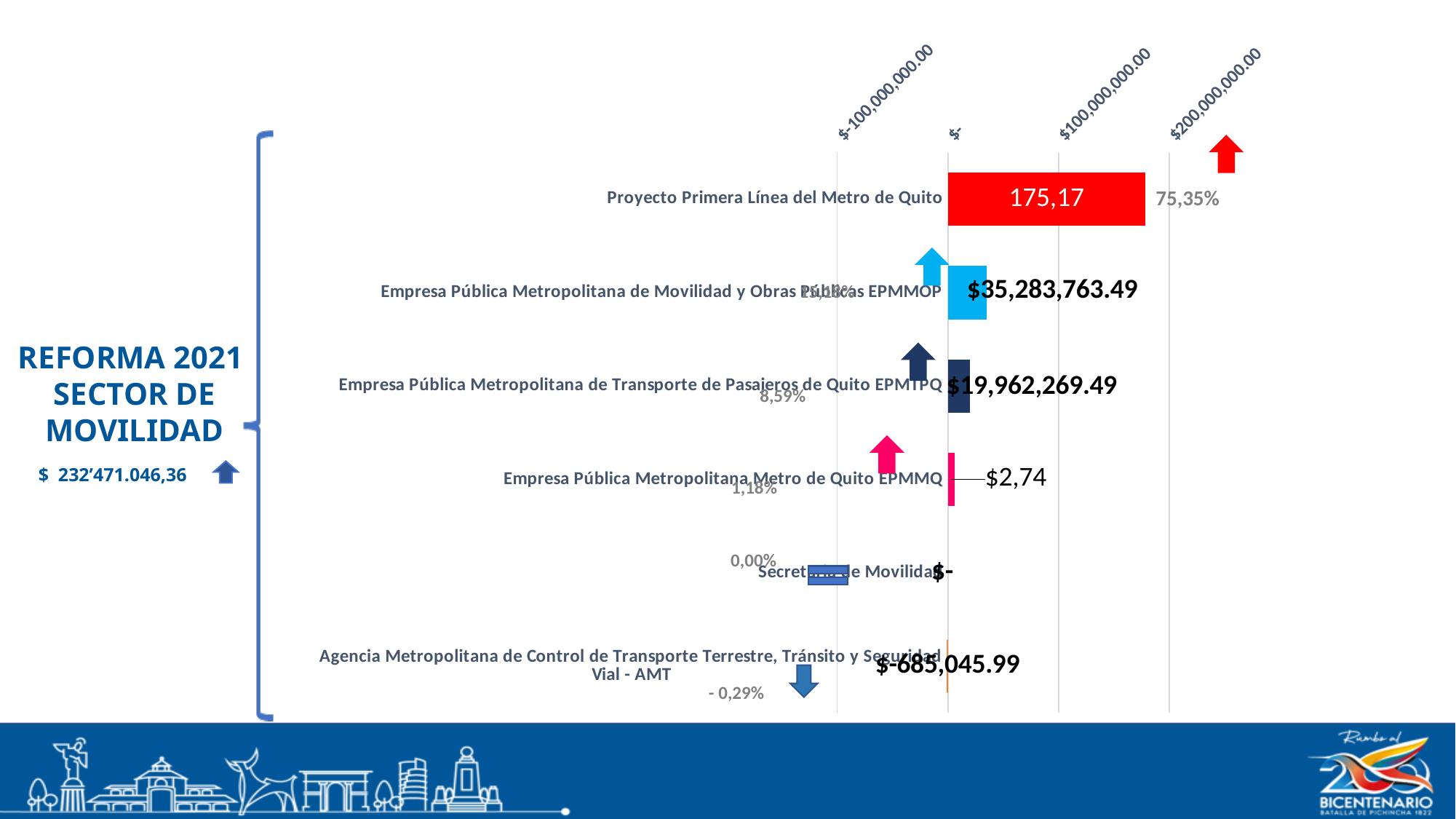
What kind of chart is shown on the slide? bar chart What is the data label shown for Empresa Pública Metropolitana de Movilidad y Obras Públicas EPMMOP? $35,283,763.49 What percentage is shown next to Proyecto Primera Línea del Metro de Quito? 75,35% How many categories are plotted in the chart? 6 What percentage is shown for Empresa Pública Metropolitana de Transporte de Pasajeros de Quito EPMTPQ? 8,59% Which category has the longest bar in the chart? Proyecto Primera Línea del Metro de Quito Is the value for Proyecto Primera Línea del Metro de Quito greater or less than $100,000,000.00? greater What data label is printed on the bar for Proyecto Primera Línea del Metro de Quito? 175,17 What is the data label shown for Empresa Pública Metropolitana de Transporte de Pasajeros de Quito EPMTPQ? $19,962,269.49 What is the data label shown for Agencia Metropolitana de Control de Transporte Terrestre, Tránsito y Seguridad Vial - AMT? $-685,045.99 Which is larger, the value for EPMMOP or the value for EPMTPQ? EPMMOP Which category has the lowest value in the chart? Agencia Metropolitana de Control de Transporte Terrestre, Tránsito y Seguridad Vial - AMT